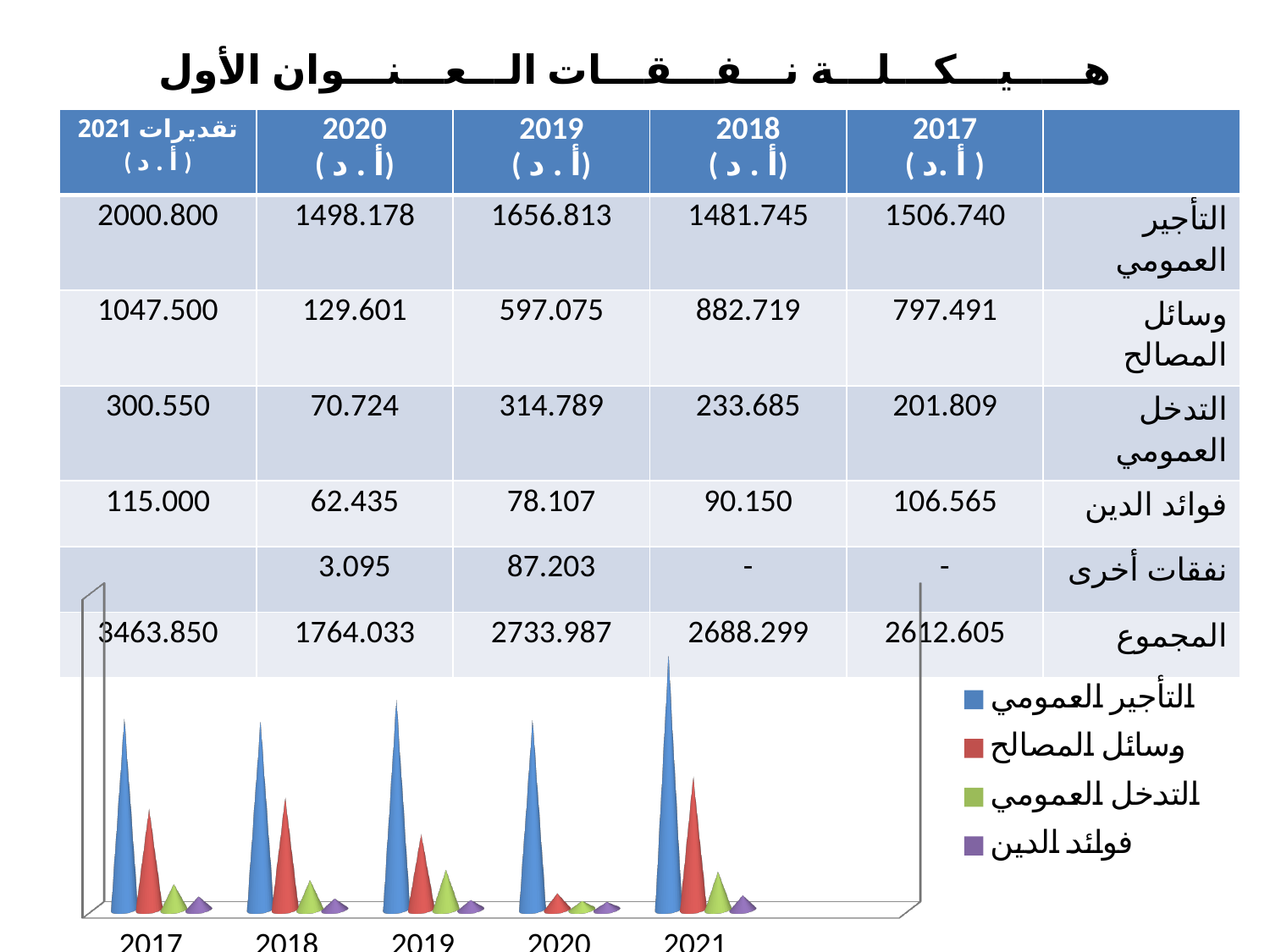
In 2017, which is larger: التأجير العمومي or وسائل المصالح? التأجير العمومي How many series does the chart legend list? 4 In which year is the bar for التأجير العمومي the tallest? 2021 In which year is the bar for التدخل العمومي the lowest? 2020 Does the bar for التأجير العمومي rise or fall from 2020 to 2021? rise What kind of chart is shown at the bottom of the slide? bar chart Which series is shown in red in the chart? وسائل المصالح How many years (categories) are shown along the x axis of the chart? 5 In which year is the bar for وسائل المصالح the lowest? 2020 What is the difference between the التأجير العمومي values for 2021 and 2020 as printed on the slide? 502.622 What is the value of التأجير العمومي for 2019 as printed on the slide? 1656.813 Which colour represents التأجير العمومي in the chart? blue